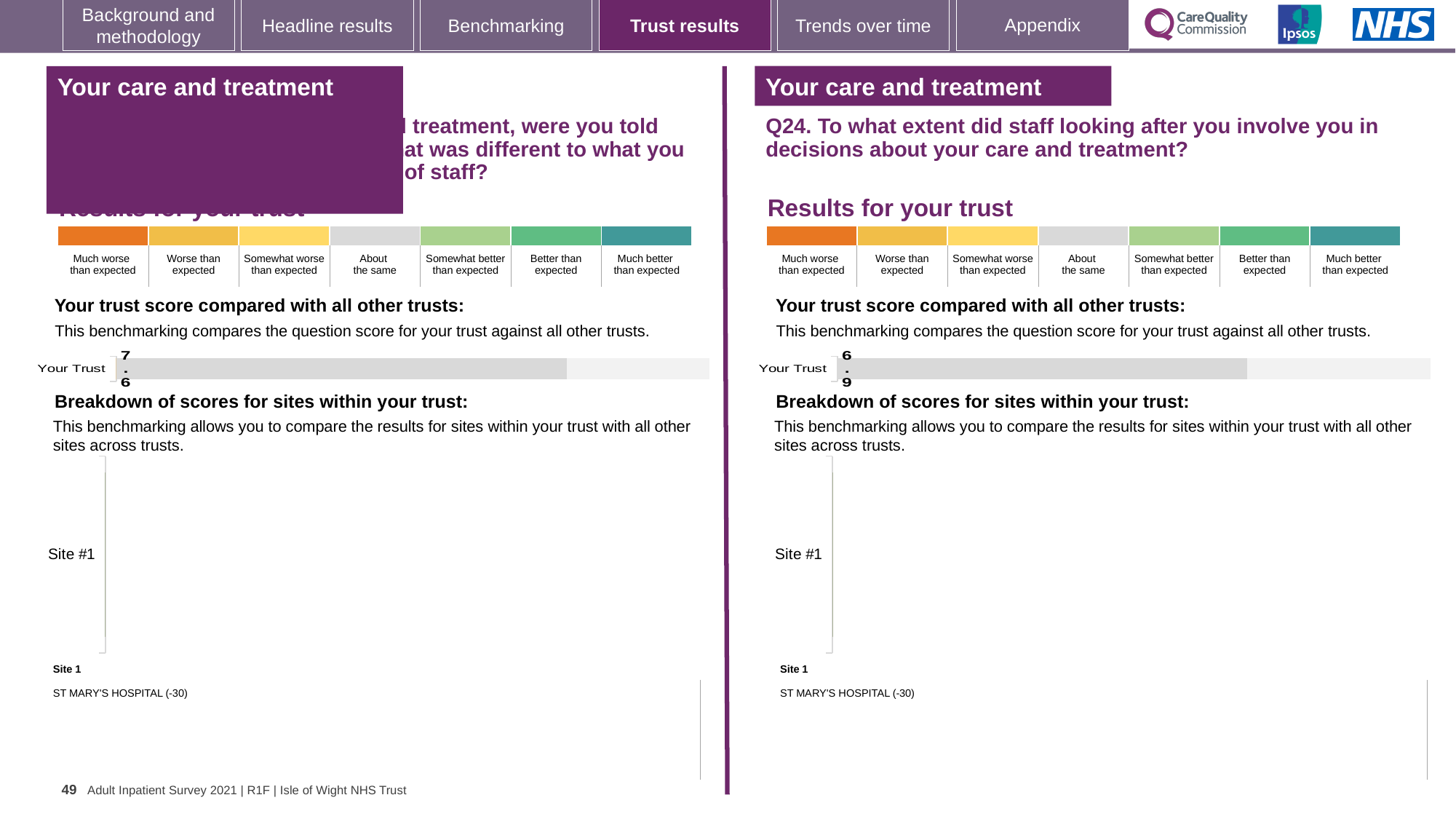
In the right panel (Q24) 'Your trust score compared with all other trusts' chart, what is the value shown for Your Trust? 6.9 How many colour bands are shown in the 'Results for your trust' scale in the right panel (Q24)? 7 Which panel's Your Trust score is larger, the left panel or the right panel (Q24)? Left panel How many sites are listed in the right panel's 'Breakdown of scores for sites within your trust' chart? 1 What is the label of the single category in the right panel's (Q24) trust score bar chart? Your Trust In the left panel's site breakdown, what is the name given for Site 1? ST MARY'S HOSPITAL (-30) What is the difference between the Your Trust score in the left panel and the Your Trust score in the right panel (Q24)? 0.7 How many categories are plotted in the left panel's 'Your trust score compared with all other trusts' chart? 1 What kind of chart is used for the 'Your trust score compared with all other trusts' section in the right panel (Q24)? Bar chart In the left panel's 'Your trust score compared with all other trusts' chart, what is the value shown for Your Trust? 7.6